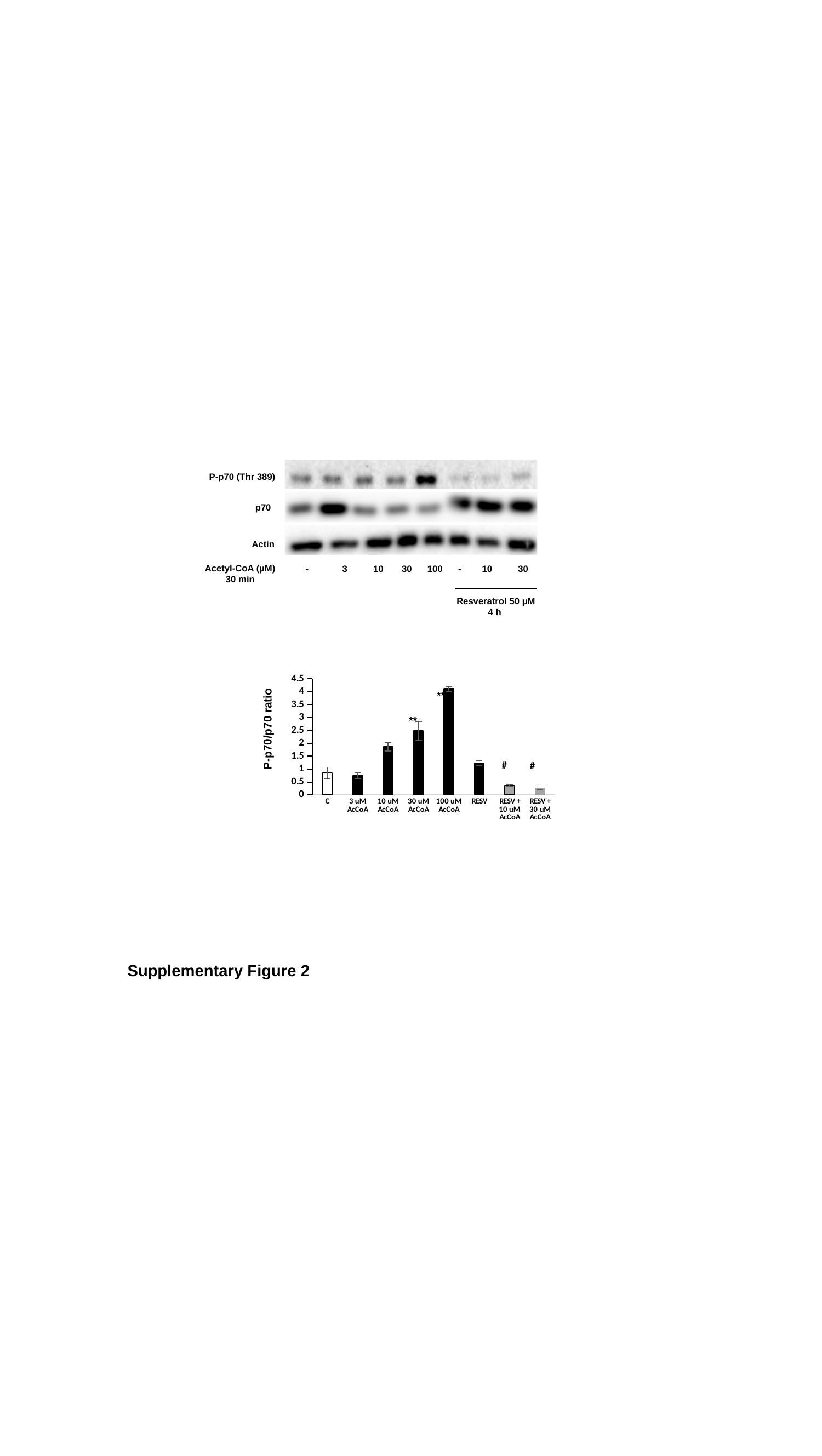
Is the value for RESV + 10 uM AcCoA greater or less than 0.5? less Which category has the highest P-p70/p70 ratio? 100 uM AcCoA What is the label of the vertical axis of the chart? P-p70/p70 ratio Is the value for C greater or less than 1? less Is the value for 30 uM AcCoA greater or less than 2? greater What kind of chart is shown on the slide? bar chart Which is larger, the value for RESV or the value for RESV + 30 uM AcCoA? RESV Do the values rise or fall from C through 10 uM, 30 uM and 100 uM AcCoA? rise How many bars (categories) are plotted in the chart? 8 Which is larger, the value for 30 uM AcCoA or the value for 10 uM AcCoA? 30 uM AcCoA